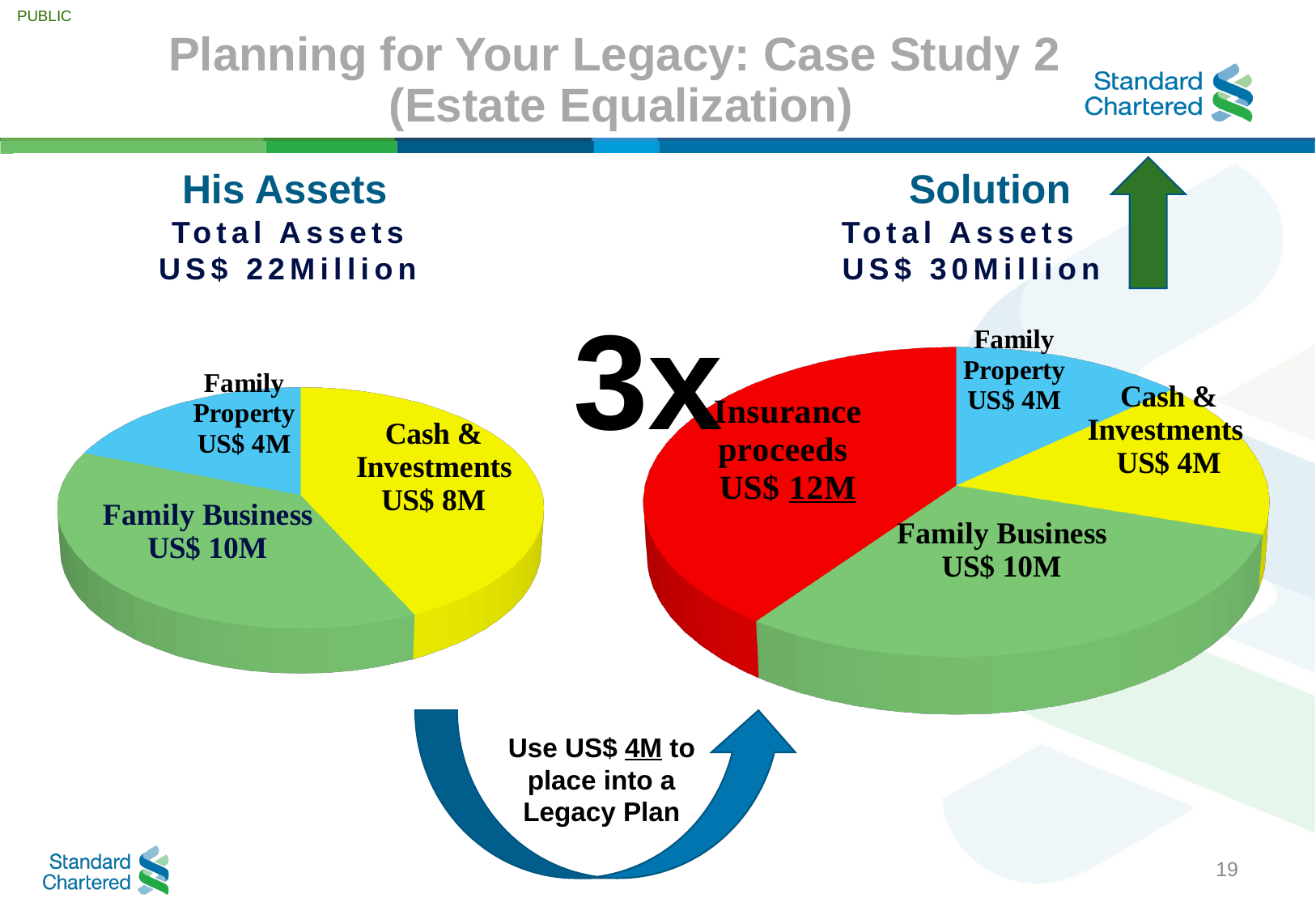
In the 'Solution' pie chart, which is larger, Insurance proceeds or Family Business? Insurance proceeds In the 'Solution' pie chart, which category has the largest value? Insurance proceeds In the 'His Assets' pie chart, what is the value of Family Business? US$ 10M In the 'His Assets' pie chart, which category has the smallest value? Family Property In the 'His Assets' pie chart, which category has the largest value? Family Business In the 'Solution' pie chart, what is the value of Cash & Investments? US$ 4M In the 'Solution' pie chart, what share of the US$ 30Million total do the Insurance proceeds represent? 40% What type of chart is used for 'His Assets'? Pie chart In the 'Solution' pie chart, what is the value of Insurance proceeds? US$ 12M In the 'His Assets' pie chart, what is the difference between Family Business and Family Property? US$ 6M How many slices does the 'Solution' pie chart have? 4 In the 'His Assets' pie chart, what is the value of Cash & Investments? US$ 8M